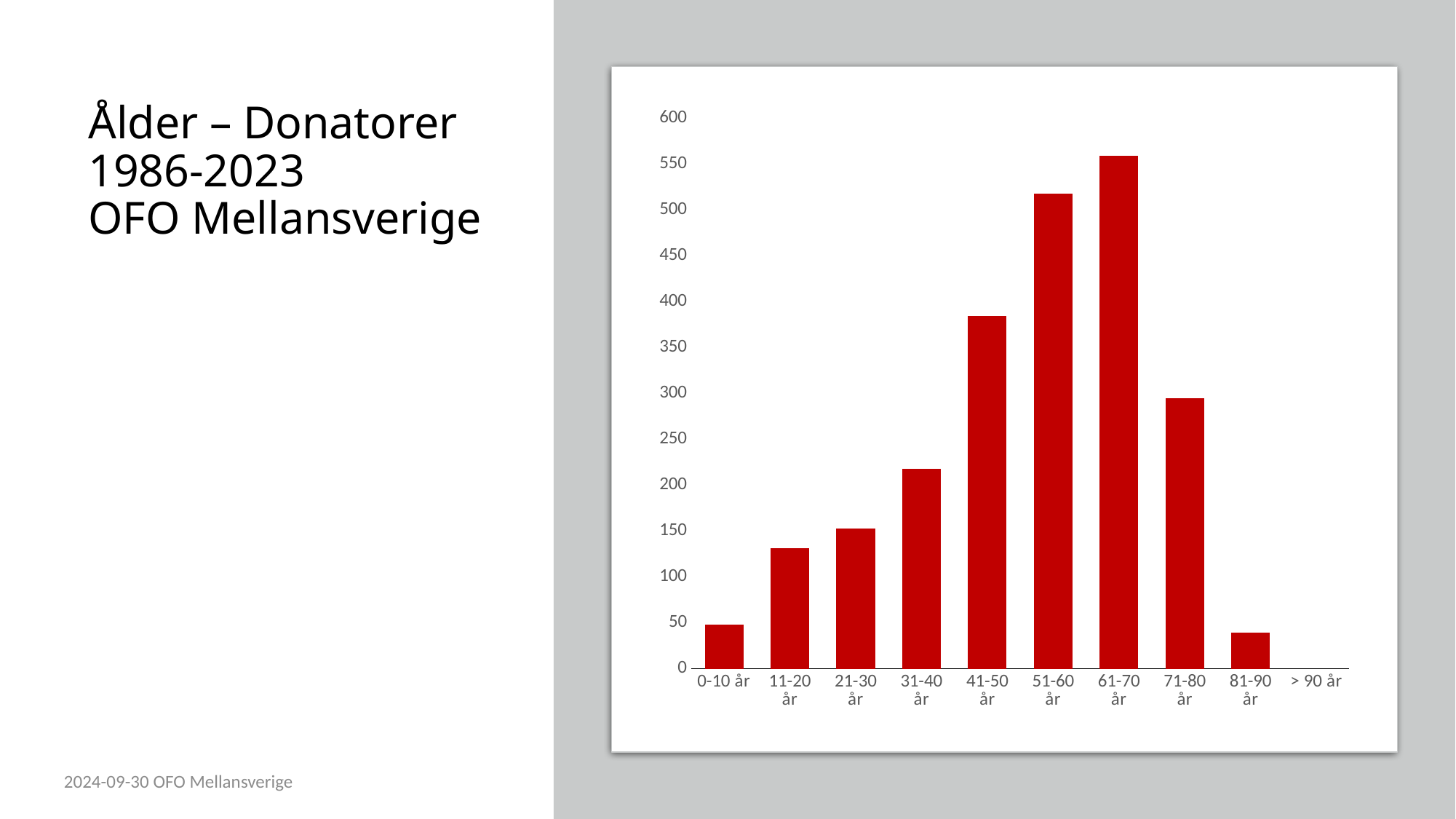
How many age-group categories are shown on the x axis? 10 Is the value for 0-10 år greater or less than 100? less How do the values change across the age groups from 0-10 år to 61-70 år? They rise Is the value for 51-60 år greater or less than 500? greater What kind of chart is shown on the slide? Bar chart Among the age groups with a visible bar, which has the lowest value? 81-90 år Which is larger, the value for 51-60 år or the value for 61-70 år? 61-70 år Is the value for 31-40 år greater or less than 200? greater Which is larger, the value for 41-50 år or the value for 71-80 år? 41-50 år Which age group has the tallest bar? 61-70 år